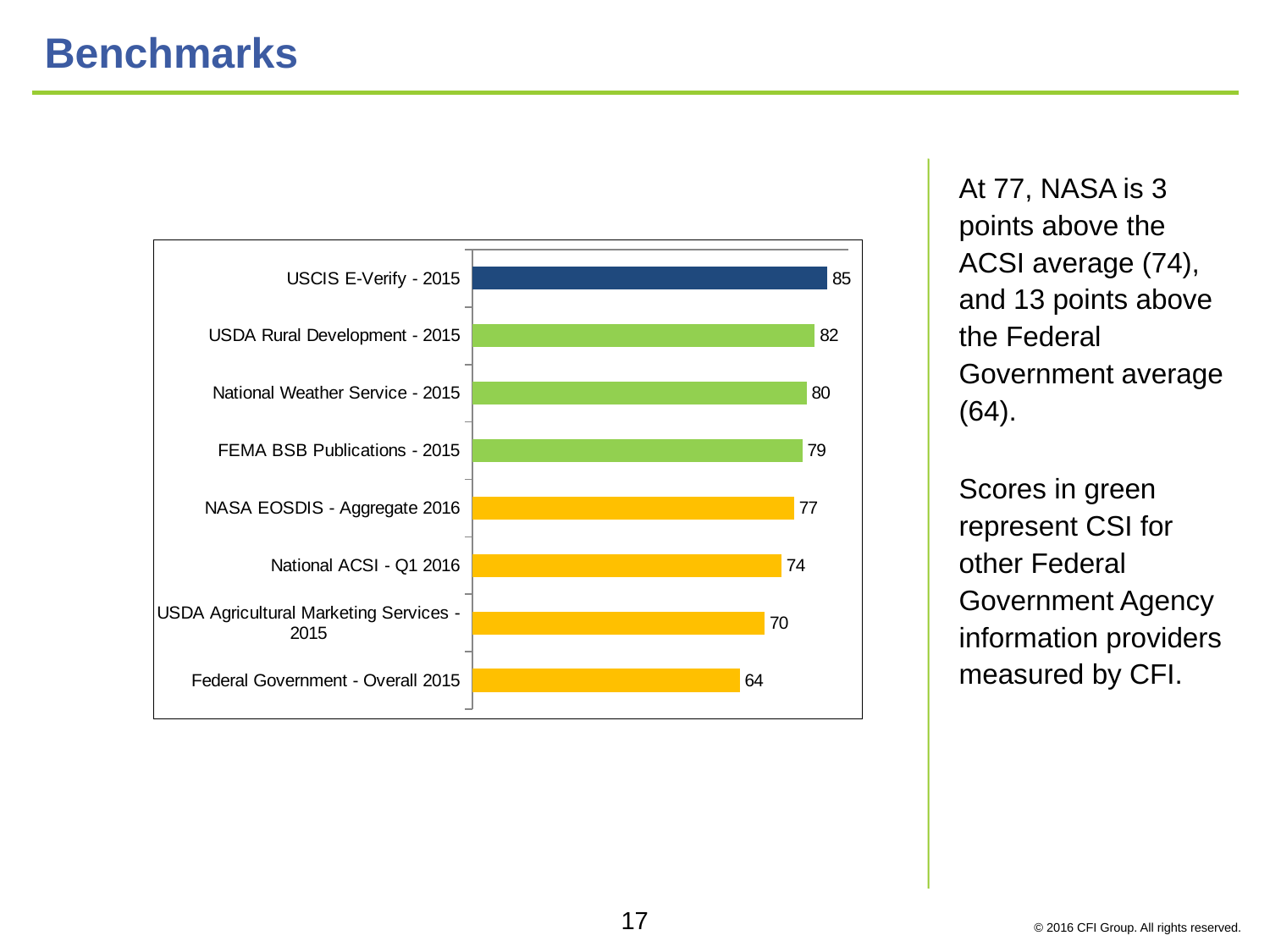
What is the value for USCIS E-Verify - 2015? 85 What is the difference between the values for USDA Rural Development - 2015 and National ACSI - Q1 2016? 8 How many categories are shown in the chart? 8 What is the difference between the values for NASA EOSDIS - Aggregate 2016 and Federal Government - Overall 2015? 13 What is the value for NASA EOSDIS - Aggregate 2016? 77 What is the value for Federal Government - Overall 2015? 64 Which category has the highest value? USCIS E-Verify - 2015 Which is larger, the value for FEMA BSB Publications - 2015 or the value for USDA Agricultural Marketing Services - 2015? FEMA BSB Publications - 2015 What colour is the bar for USCIS E-Verify - 2015? Dark blue What is the value for National Weather Service - 2015? 80 What kind of chart is shown on the slide? Bar chart Which category has the lowest value? Federal Government - Overall 2015